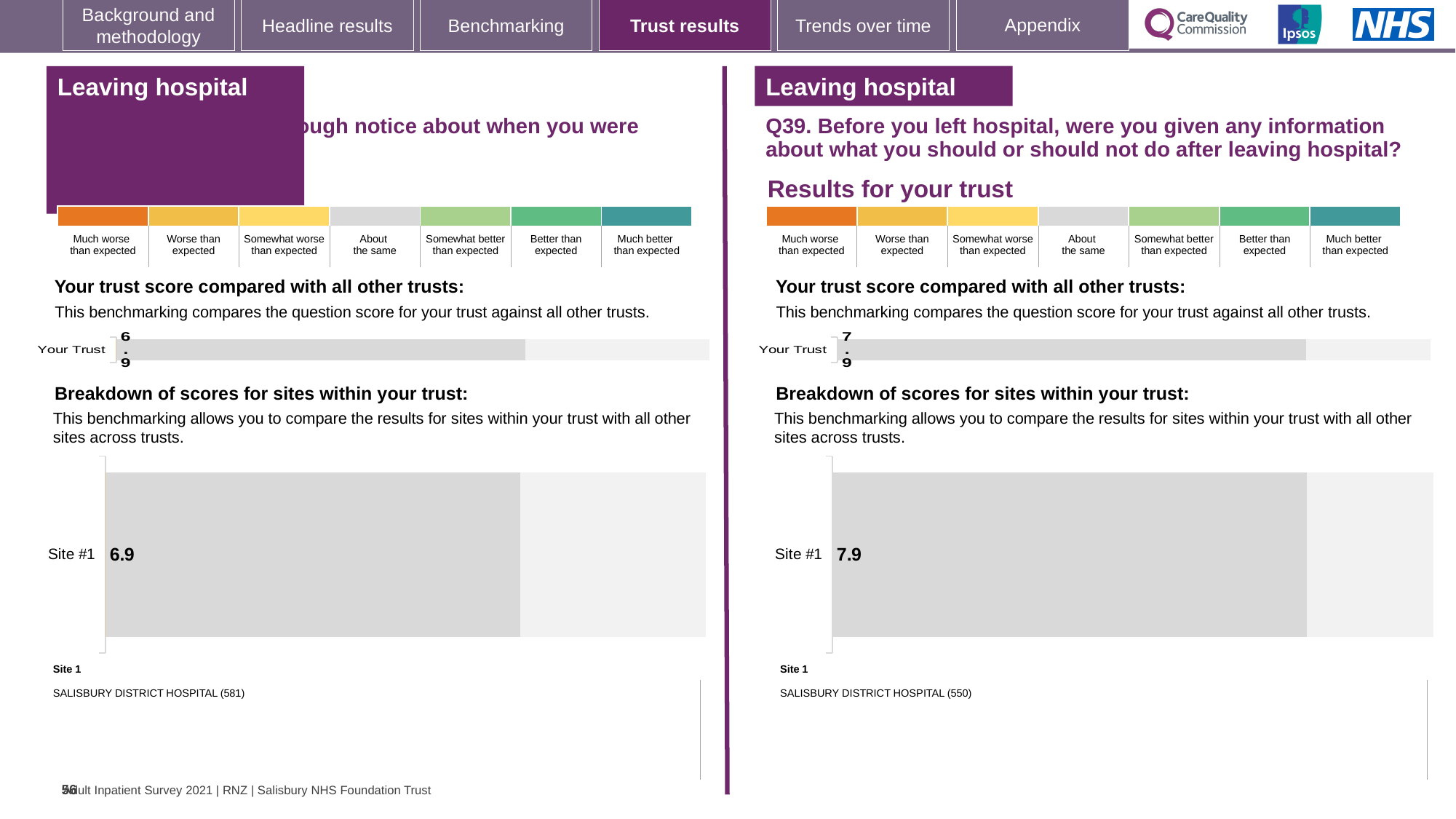
What type of chart is used to show the Site #1 score on the right-hand side of the slide? Bar chart In the right-hand 'Breakdown of scores for sites within your trust' chart (Q39), what is the score for Site #1? 7.9 How many sites are shown in the left-hand 'Breakdown of scores for sites within your trust' chart? 1 Is the Your Trust score on the right-hand side of the slide (Q39) greater or less than the Your Trust score on the left-hand side? greater On the left-hand side of the slide, what is the score shown for Your Trust? 6.9 How many sites are shown in the right-hand 'Breakdown of scores for sites within your trust' chart? 1 In the left-hand 'Breakdown of scores for sites within your trust' chart, what is the score for Site #1? 6.9 Which hospital is listed as Site 1 on the left-hand side of the slide? SALISBURY DISTRICT HOSPITAL (581) Which is larger: the Site #1 score in the left-hand breakdown chart or the Site #1 score in the right-hand breakdown chart? The right-hand chart (7.9) What is the difference between the Site #1 score in the right-hand breakdown chart and the Site #1 score in the left-hand breakdown chart? 1.0 On the right-hand side of the slide (Q39), what is the score shown for Your Trust? 7.9 Which hospital is listed as Site 1 on the right-hand side of the slide? SALISBURY DISTRICT HOSPITAL (550)